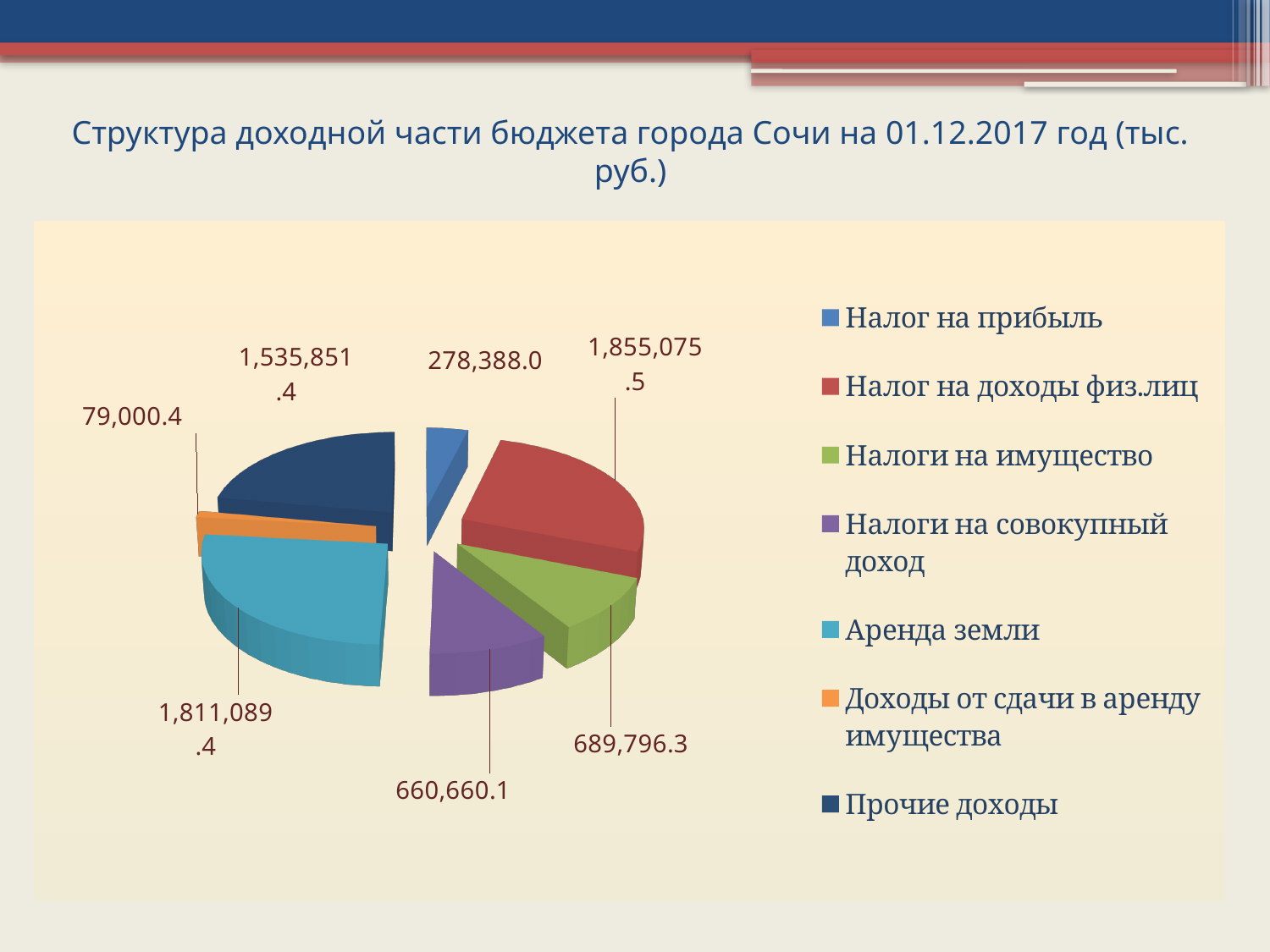
What is the value for Налог на доходы физ.лиц? 1,855,075.5 What is the value for Аренда земли? 1,811,089.4 Which category has the largest value? Налог на доходы физ.лиц Which category has the smallest value? Доходы от сдачи в аренду имущества What type of chart is shown on the slide? Pie chart What is the title of the chart on the slide? Структура доходной части бюджета города Сочи на 01.12.2017 год (тыс. руб.) What is the value for Налог на прибыль? 278,388.0 What is the difference between Налоги на имущество and Налоги на совокупный доход? 29,136.2 What is the value for Налоги на совокупный доход? 660,660.1 How many categories does the pie chart have? 7 Which is larger: Аренда земли or Прочие доходы? Аренда земли What is the value for Прочие доходы? 1,535,851.4